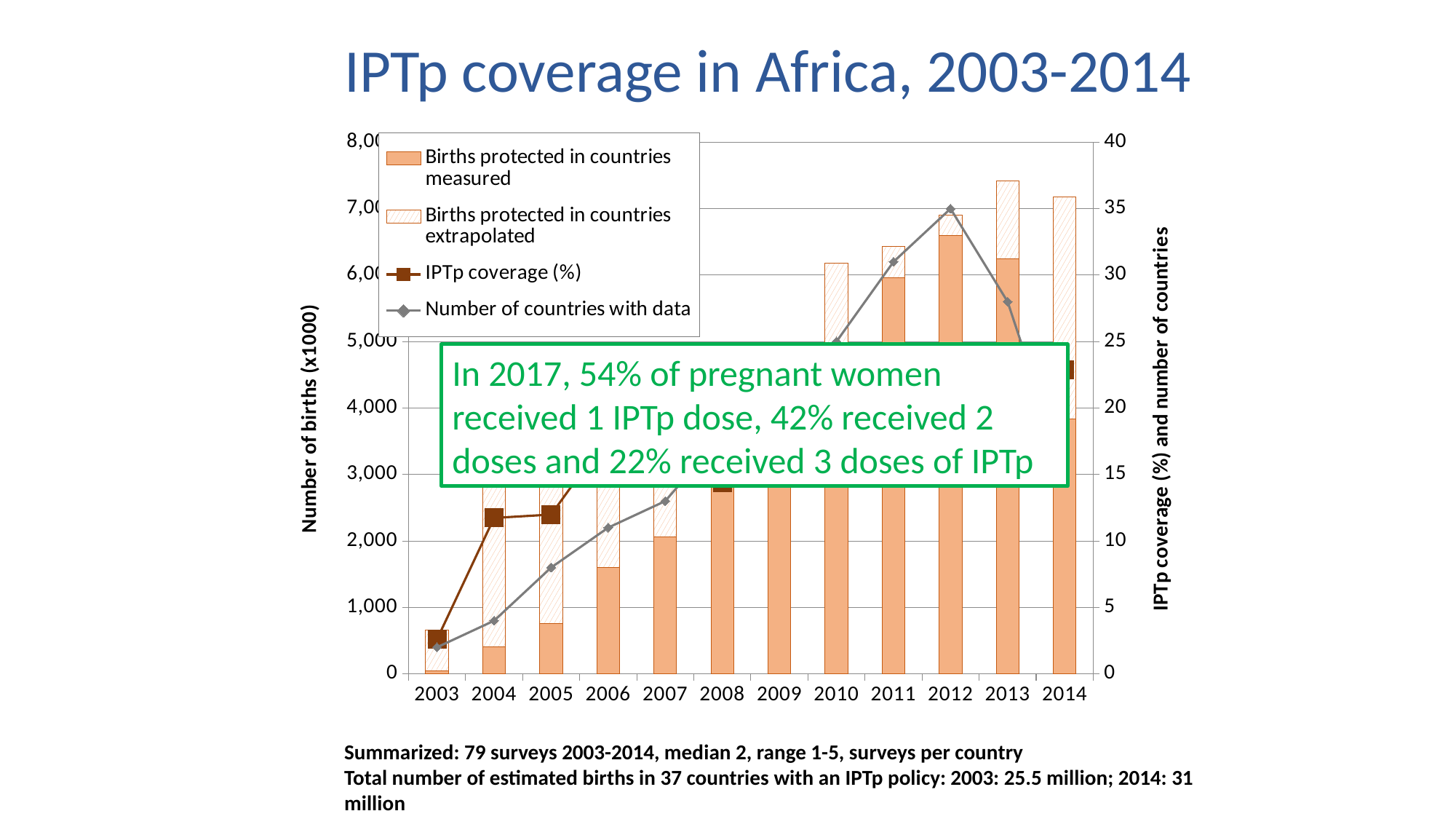
Does the Number of countries with data rise or fall from 2003 to 2012? rise What is the title of the chart on the slide? IPTp coverage in Africa, 2003-2014 Is the IPTp coverage (%) in 2004 greater or less than 10? greater Which year has the highest value for Births protected in countries measured? 2012 Is the Number of countries with data in 2005 greater or less than 10? less What is the label of the left vertical axis? Number of births (x1000) How many years are shown on the x axis of the chart? 12 Is the value for Births protected in countries measured in 2006 greater or less than 2,000? less How many series does the chart legend list? 4 What kind of chart is shown on the slide? Combined bar and line chart Which year has the lowest value for Births protected in countries measured? 2003